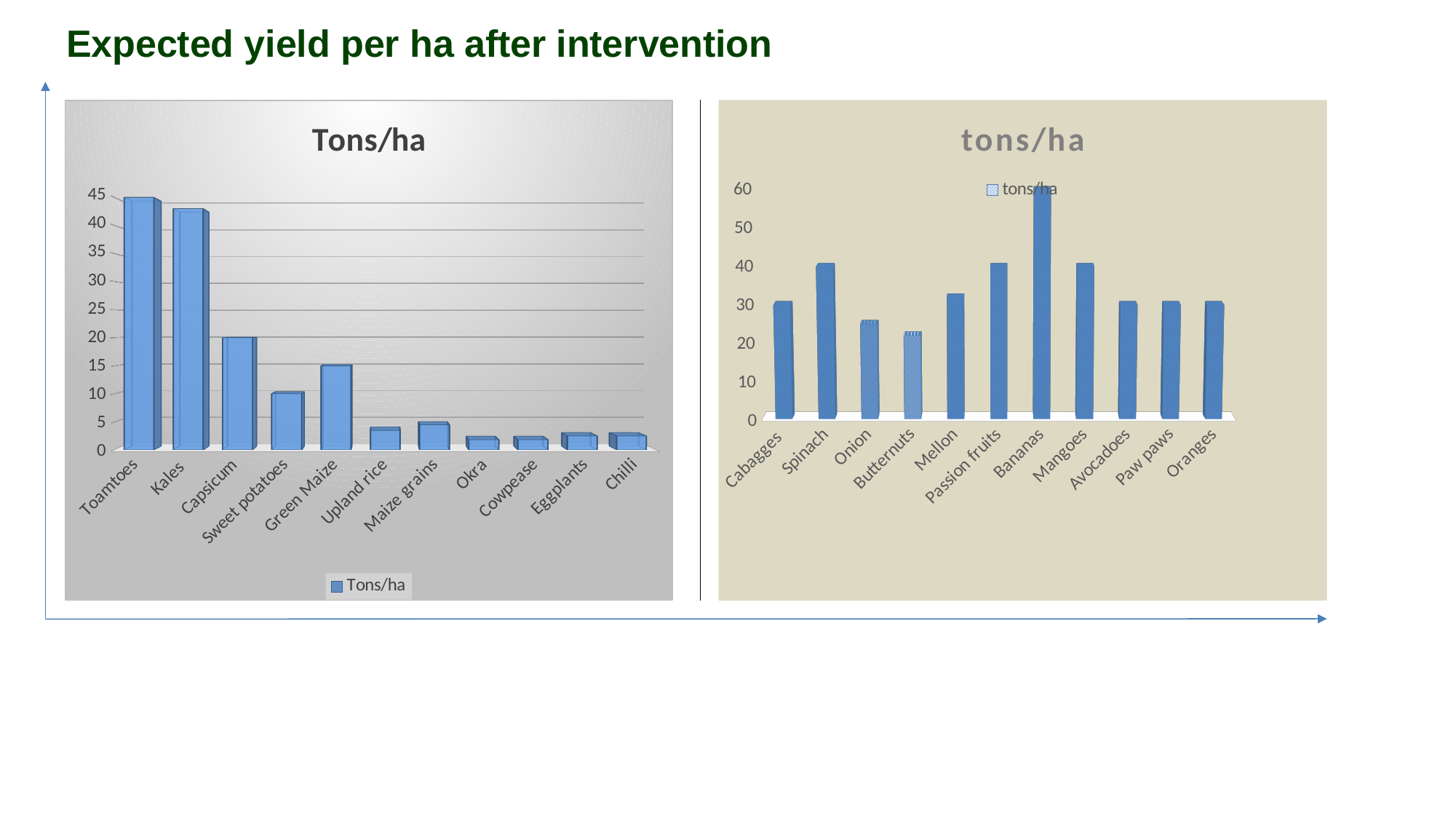
In the right chart titled "tons/ha", which has the larger value, Spinach or Onion? Spinach In the left chart titled "Tons/ha", how many crop categories are shown on the x axis? 11 What kind of chart is the left chart titled "Tons/ha"? bar chart In the left chart titled "Tons/ha", is the value for Sweet potatoes greater or less than 15? less In the left chart titled "Tons/ha", is the value for Okra greater or less than 5? less In the right chart titled "tons/ha", how many series does the legend list? 1 In the left chart titled "Tons/ha", which crop has the highest expected yield? Toamtoes In the right chart titled "tons/ha", which crop has the highest expected yield? Bananas In the left chart titled "Tons/ha", is the value for Kales greater or less than 40? greater In the left chart titled "Tons/ha", which has the larger value, Capsicum or Green Maize? Capsicum In the right chart titled "tons/ha", how many crop categories are shown on the x axis? 11